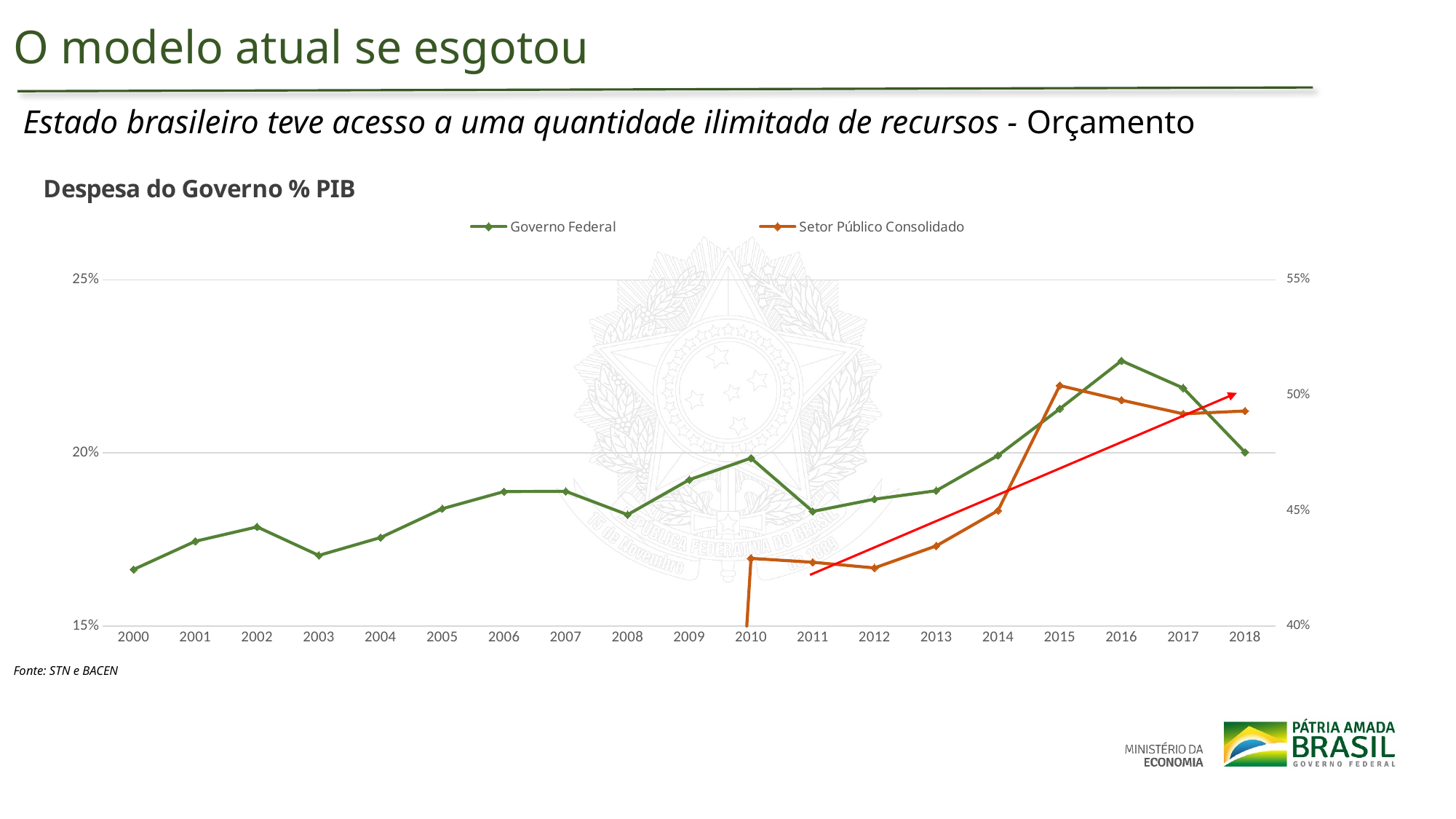
What is the title of the chart? Despesa do Governo % PIB How many years are shown on the x axis? 19 In which year does the Setor Público Consolidado series reach its highest value? 2015 In which year does the Governo Federal series have its lowest value? 2000 How many series does the legend list? 2 Is the Governo Federal value for 2016 greater or less than 20%? greater What kind of chart is shown on the slide? Line chart Which series is drawn in green? Governo Federal Is the Setor Público Consolidado value for 2012 greater or less than 45%? less Which is larger for Governo Federal: the value in 2016 or the value in 2018? 2016 In which year does the Governo Federal series reach its highest value? 2016 Does the Governo Federal series rise or fall from 2016 to 2018? Fall